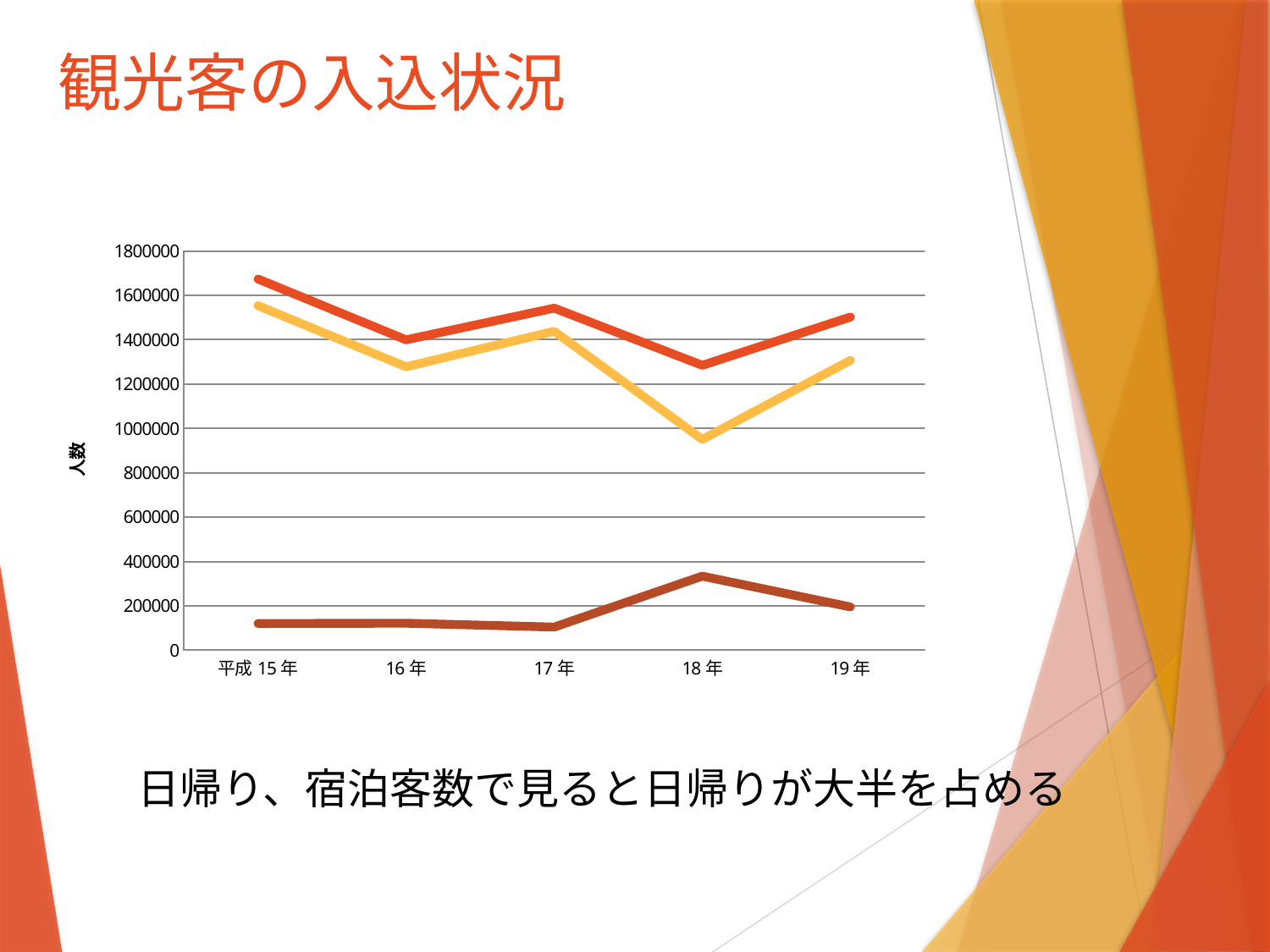
In which year does the yellow (middle) line reach its lowest value? 18年 What is the title of the slide containing the chart? 観光客の入込状況 Is the value of the yellow (middle) line at 18年 greater or less than 1000000? less In which year does the red (top) line reach its highest value? 平成15年 What kind of chart is shown on the slide? line chart What is the label on the vertical axis of the chart? 人数 Is the value of the brown (bottom) line at 17年 greater or less than 200000? less Does the brown (bottom) line rise or fall from 17年 to 18年? rise Is the value of the red (top) line at 18年 greater or less than 1400000? less How many years are plotted along the x axis of the chart? 5